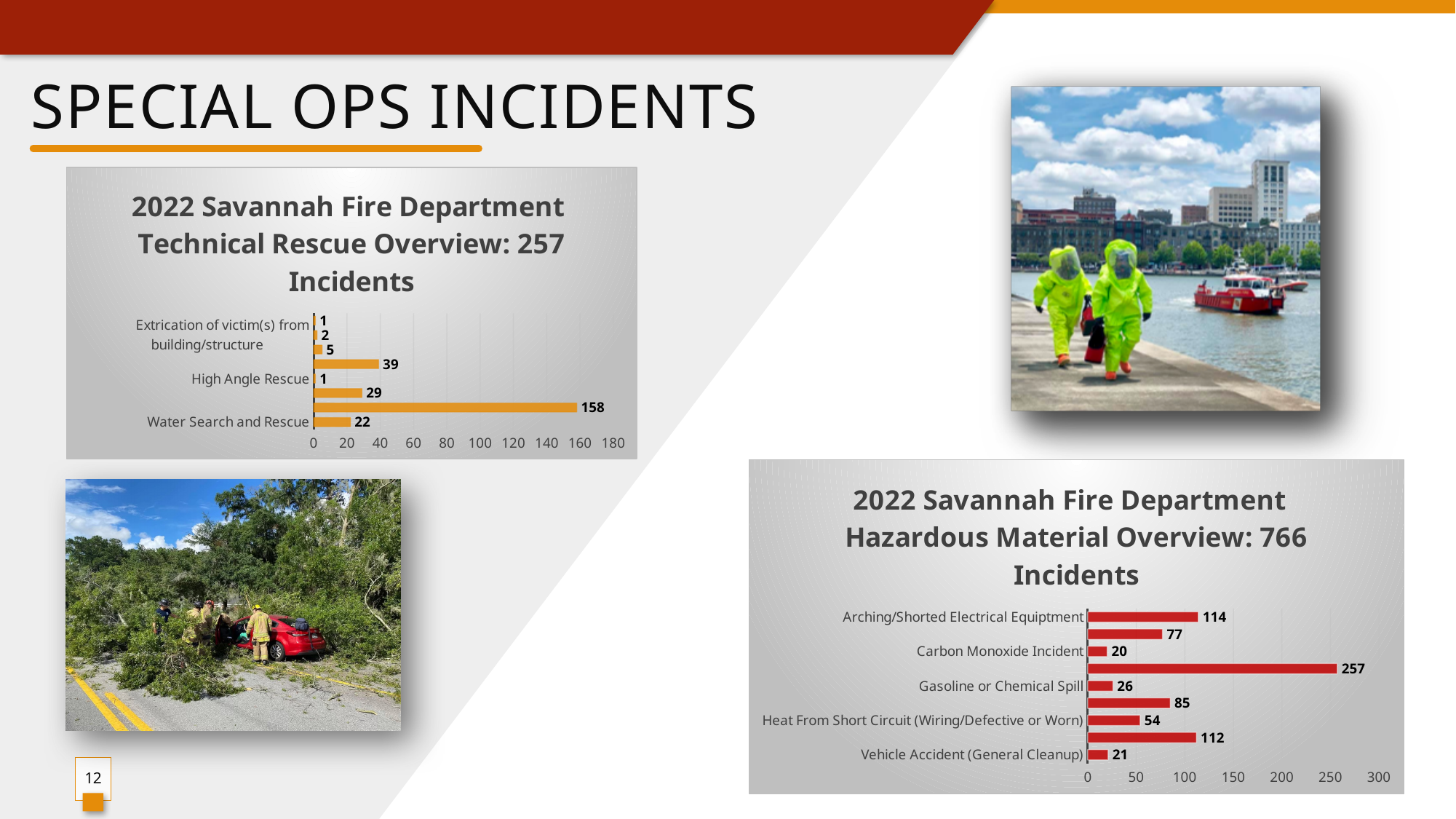
In the Hazardous Material Overview chart, what is the value for Carbon Monoxide Incident? 20 In the Technical Rescue Overview chart, what is the value for Water Search and Rescue? 22 In the Technical Rescue Overview chart, what is the largest value shown on any bar? 158 In the Hazardous Material Overview chart, what is the value for Heat From Short Circuit (Wiring/Defective or Worn)? 54 In the Hazardous Material Overview chart, how many bars are plotted? 9 What type of chart is the Technical Rescue Overview chart? Bar chart In the Hazardous Material Overview chart, what is the value for Vehicle Accident (General Cleanup)? 21 In the Hazardous Material Overview chart, what is the difference between Arching/Shorted Electrical Equiptment and Gasoline or Chemical Spill? 88 In the Hazardous Material Overview chart, which labeled category has the lowest value? Carbon Monoxide Incident In the Hazardous Material Overview chart, what is the largest value shown on any bar? 257 In the Technical Rescue Overview chart, what is the value for High Angle Rescue? 1 In the Hazardous Material Overview chart, what is the value for Arching/Shorted Electrical Equiptment? 114